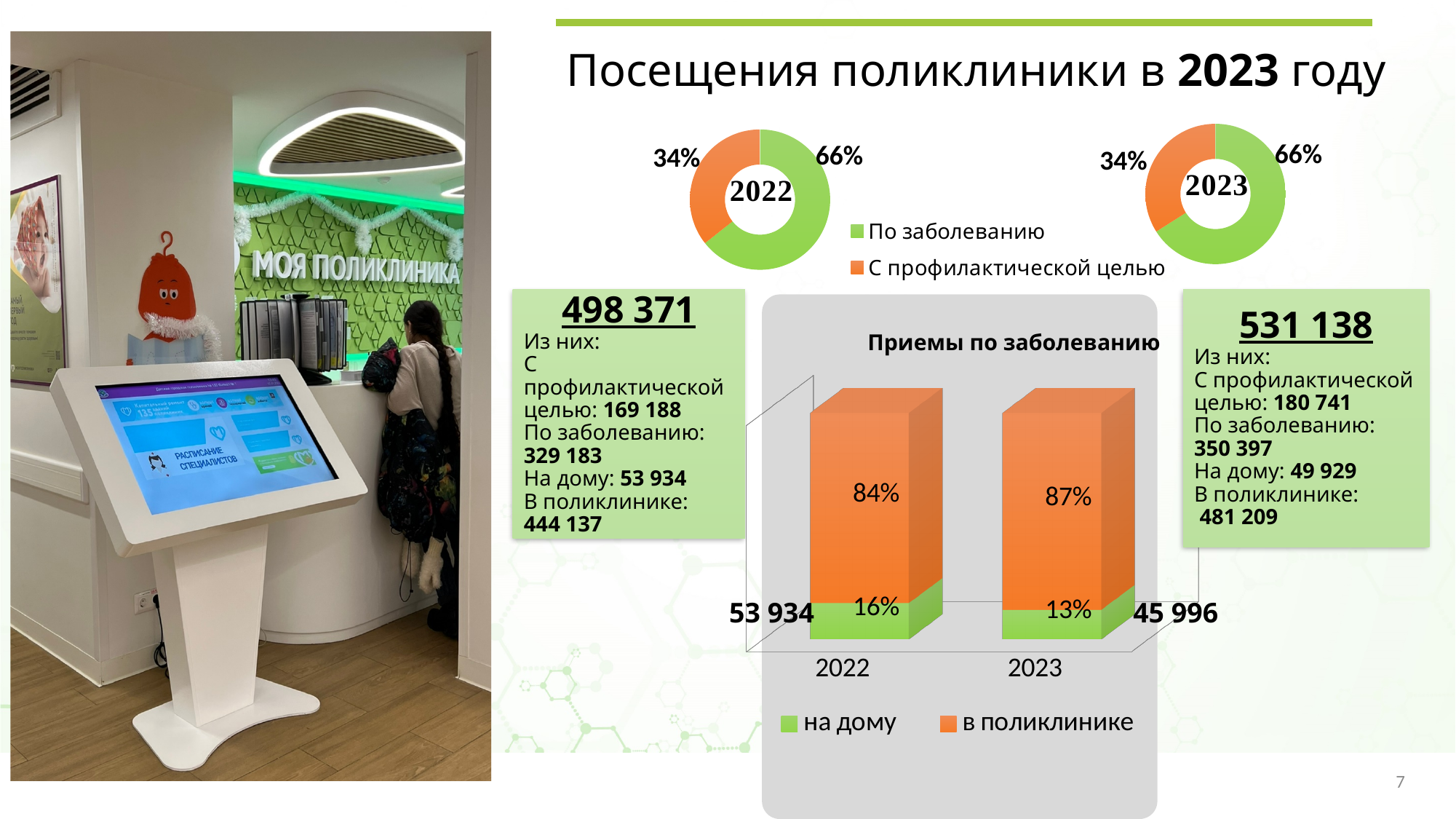
In the 2023 donut chart, which category has the larger share: "По заболеванию" or "С профилактической целью"? По заболеванию In the "Приемы по заболеванию" chart, what percentage is shown for "в поликлинике" in 2023? 87% In the "Приемы по заболеванию" chart, does the "на дому" share rise or fall from 2022 to 2023? fall In the 2022 donut chart, what share of visits is labelled "По заболеванию"? 66% What kind of chart is "Приемы по заболеванию"? stacked bar chart In the 2023 donut chart, what share of visits is labelled "По заболеванию"? 66% In the "Приемы по заболеванию" chart, what number is printed next to the 2023 bar? 45 996 In the 2022 donut chart, what share of visits is labelled "С профилактической целью"? 34% In the "Приемы по заболеванию" chart, what percentage is shown for "на дому" in 2023? 13% How many series does the legend of the donut charts list? 2 In the "Приемы по заболеванию" chart, what is the difference between the "на дому" percentages for 2022 and 2023? 3% In the "Приемы по заболеванию" chart, what percentage is shown for "в поликлинике" in 2022? 84%